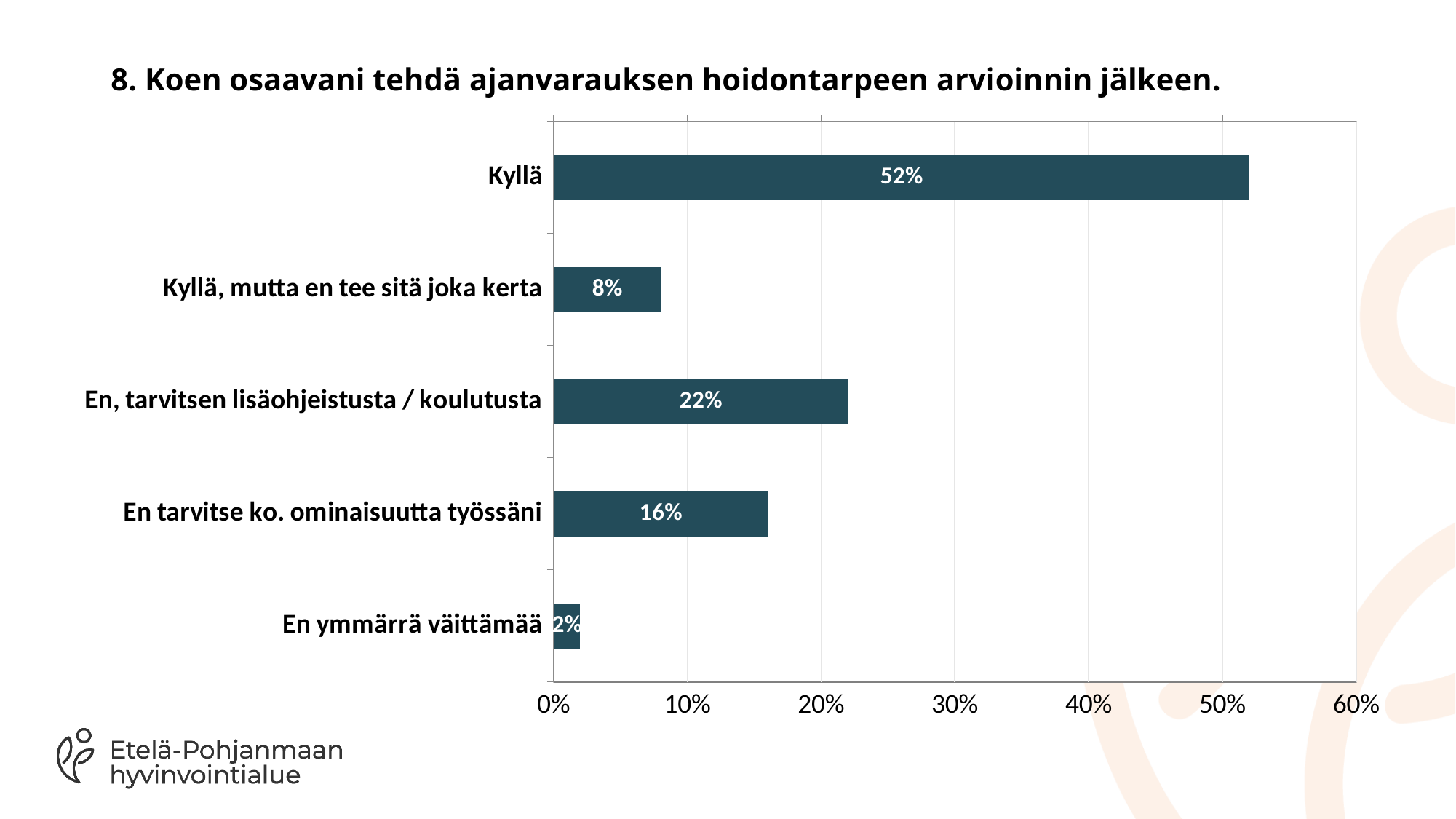
What is the title of the chart? 8. Koen osaavani tehdä ajanvarauksen hoidontarpeen arvioinnin jälkeen. Which is larger: the value for "Kyllä, mutta en tee sitä joka kerta" or the value for "En tarvitse ko. ominaisuutta työssäni"? En tarvitse ko. ominaisuutta työssäni Is the value for "Kyllä" greater or less than 50%? greater What is the value for "En tarvitse ko. ominaisuutta työssäni"? 16% Which category has the lowest value? En ymmärrä väittämää What is the value for "Kyllä"? 52% What is the difference between the values for "Kyllä" and "En, tarvitsen lisäohjeistusta / koulutusta"? 30% How many categories are shown in the chart? 5 What is the value for "En ymmärrä väittämää"? 2% What is the value for "En, tarvitsen lisäohjeistusta / koulutusta"? 22% What kind of chart is shown on the slide? bar chart Which category has the highest value? Kyllä